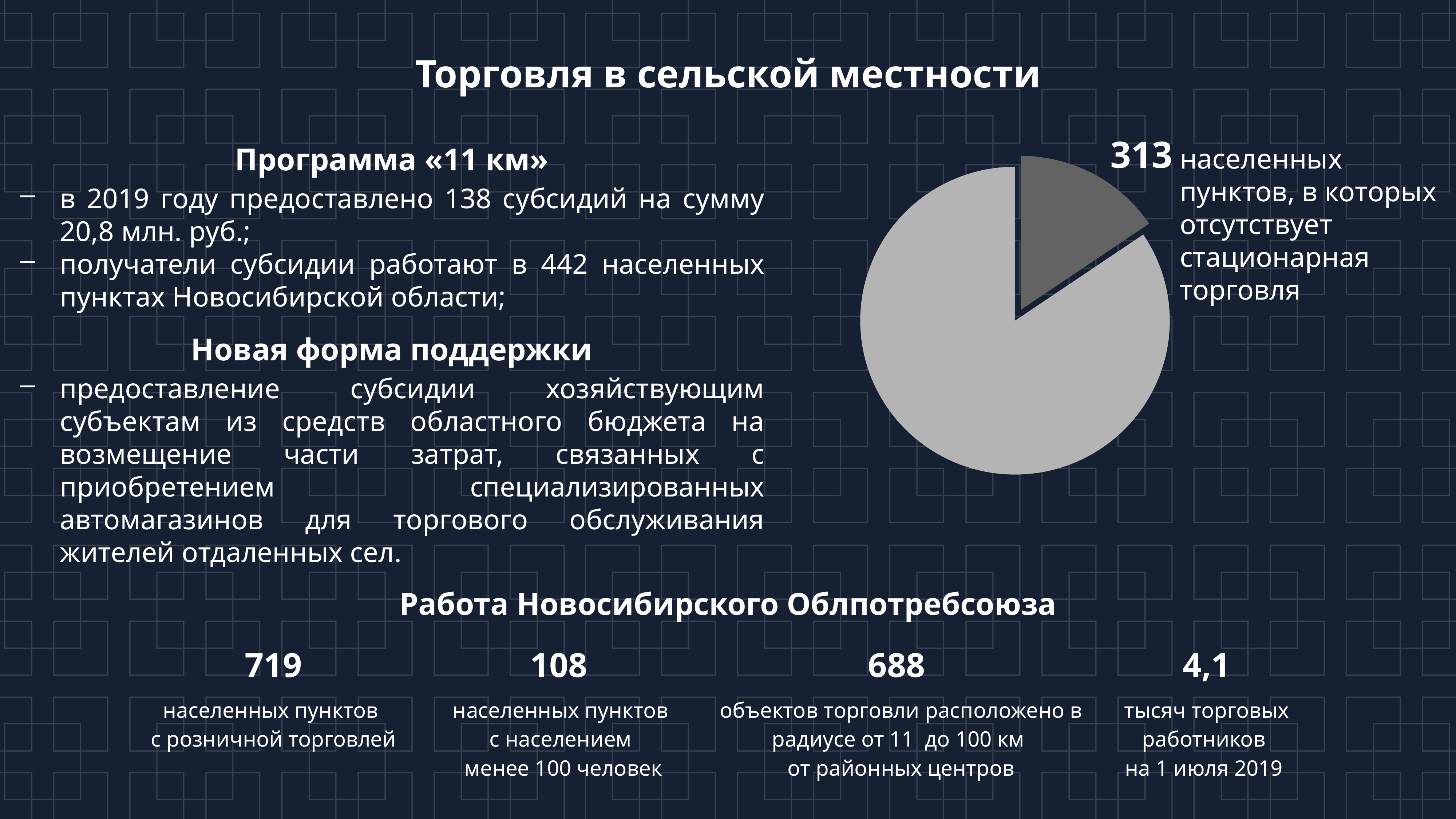
Which slice of the pie chart is the smallest? the dark grey slice What number is printed next to the dark grey slice of the pie chart? 313 How many slices does the pie chart have? 2 What kind of chart is shown on the right side of the slide? pie chart Which slice of the pie chart is larger, the light grey one or the dark grey one? the light grey one Does the pie chart have a legend? no Which slice of the pie chart is pulled out (exploded) from the rest of the pie? the dark grey slice According to the text next to the pie chart, how many населенных пунктов have no стационарная торговля? 313